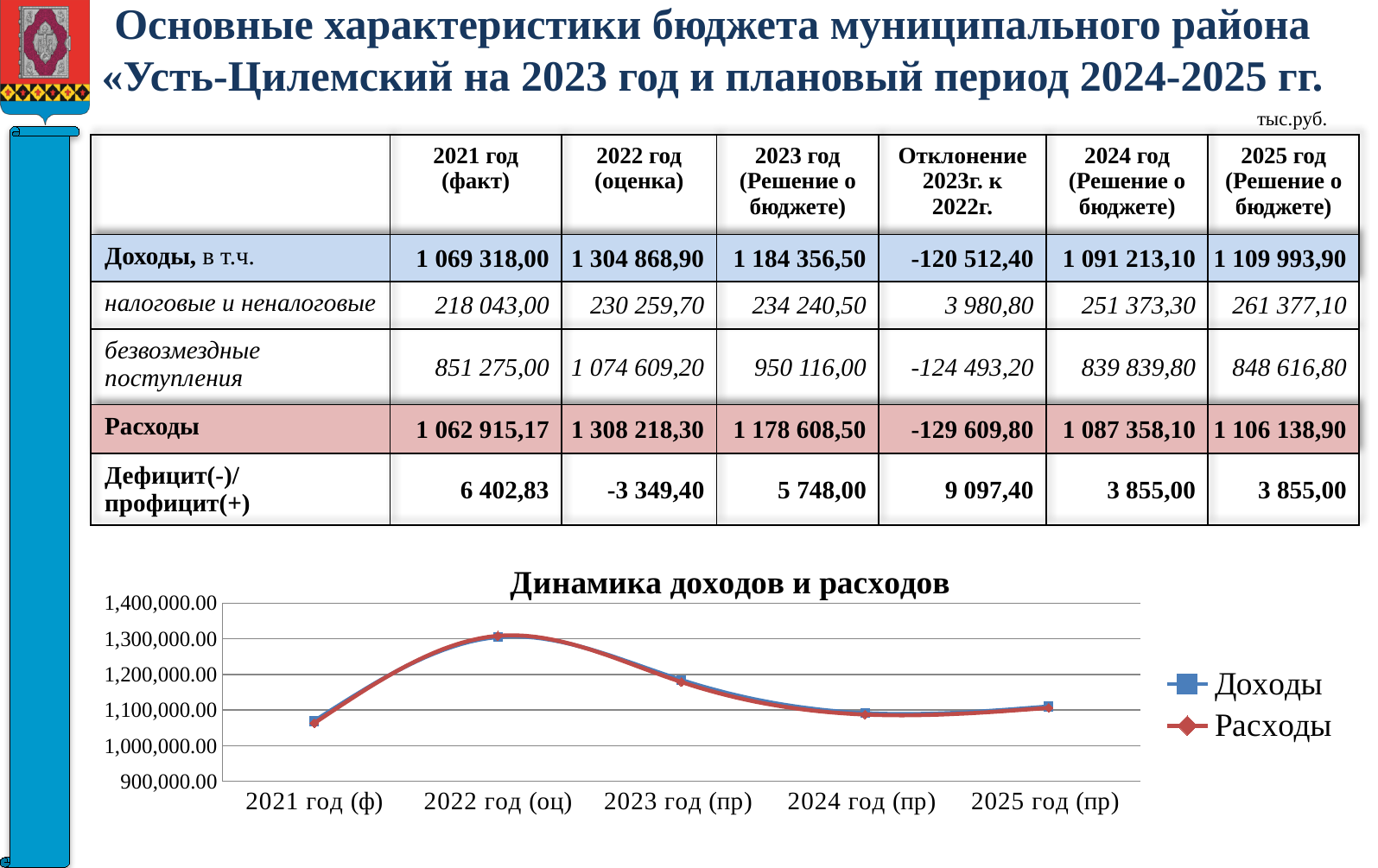
How many series does the legend of the chart "Динамика доходов и расходов" list? 2 In the chart "Динамика доходов и расходов", which category has the lowest value for Расходы? 2021 год (ф) In the chart "Динамика доходов и расходов", which category has the highest value for Доходы? 2022 год (оц) In the chart "Динамика доходов и расходов", is the value of Доходы for 2021 год (ф) greater or less than 1,100,000.00? less In the chart "Динамика доходов и расходов", is the value of Расходы for 2022 год (оц) greater or less than 1,200,000.00? greater What is the title of the line chart on the slide? Динамика доходов и расходов In the chart "Динамика доходов и расходов", do the values rise or fall from 2021 год (ф) to 2022 год (оц)? rise In the chart "Динамика доходов и расходов", is the value of Доходы for 2023 год (пр) greater or less than 1,100,000.00? greater How many categories are shown on the x axis of the chart "Динамика доходов и расходов"? 5 What type of chart is "Динамика доходов и расходов"? line chart In the chart "Динамика доходов и расходов", which series is drawn in red? Расходы In the chart "Динамика доходов и расходов", do the values rise or fall from 2022 год (оц) to 2024 год (пр)? fall